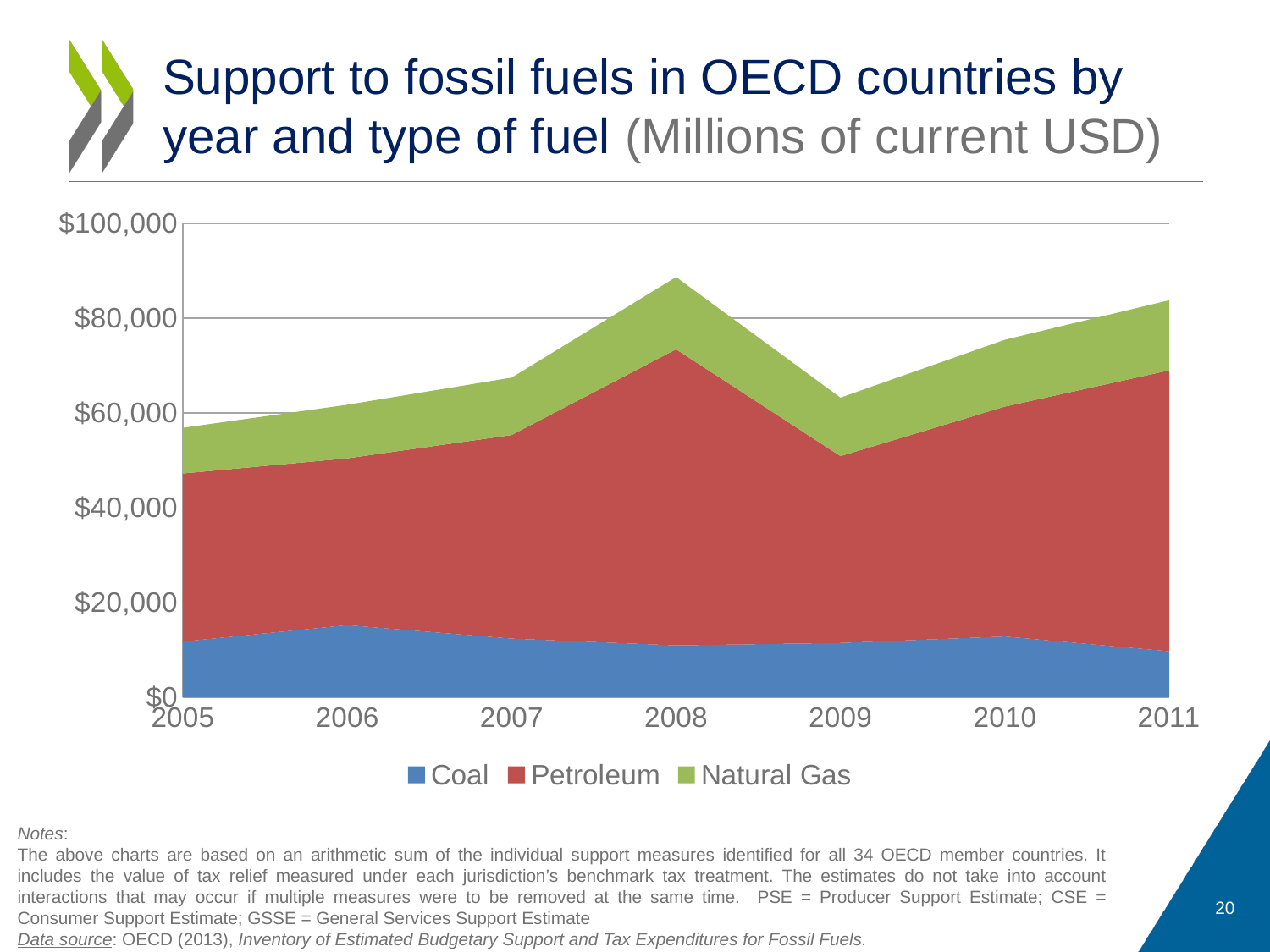
How many years are shown along the x axis? 7 Which year has the lowest total support to fossil fuels? 2005 Which series is shown in green? Natural Gas Which year has the larger total support, 2008 or 2010? 2008 Is the value for Coal in 2006 greater or less than $20,000? less Does the total support rise or fall from 2009 to 2011? Rise Is the total support in 2011 greater or less than $80,000? greater Is the total support in 2008 greater or less than $80,000? greater How many series does the legend list? 3 Which year has the highest total support to fossil fuels? 2008 What kind of chart is shown on the slide? Stacked area chart